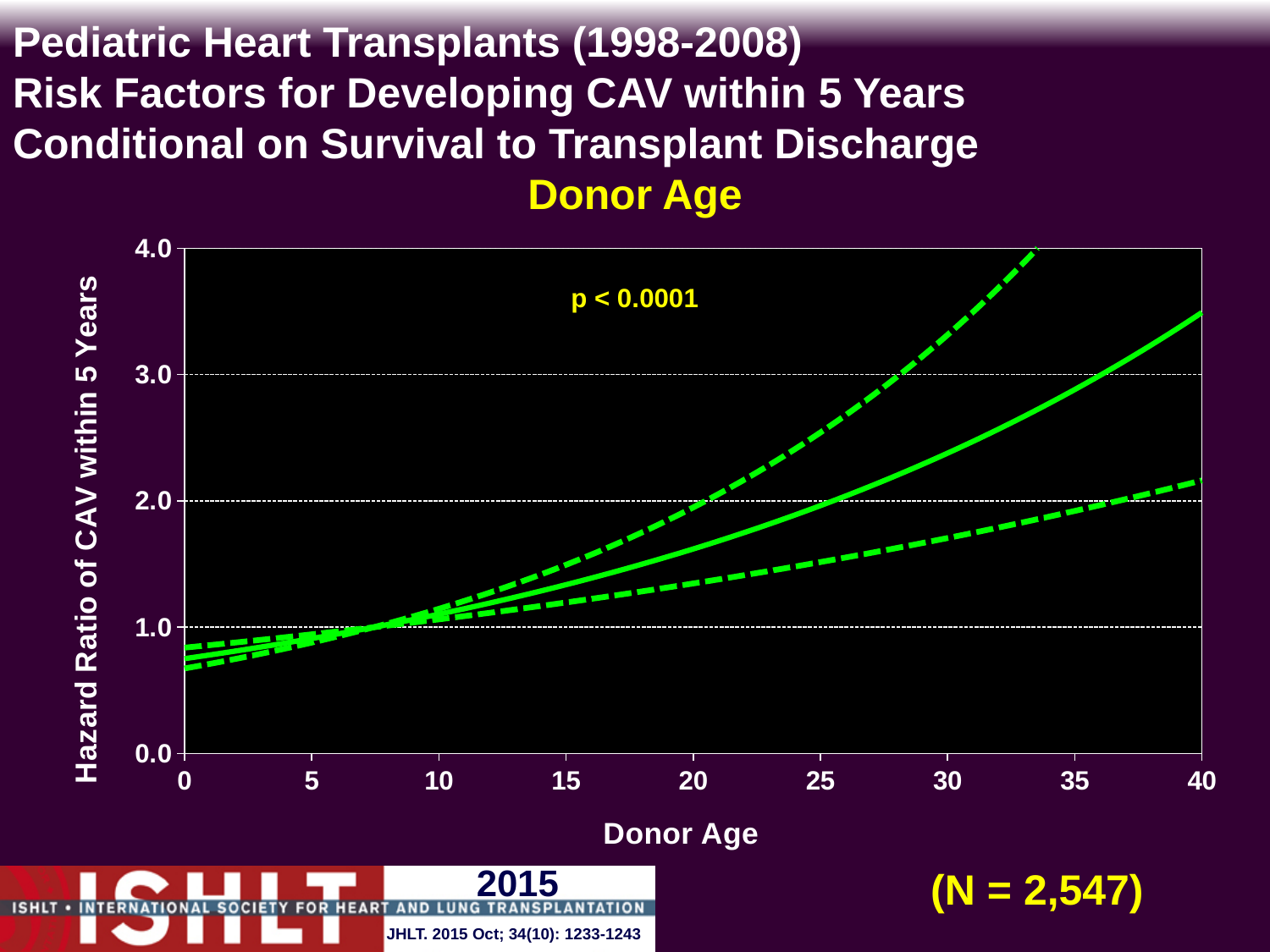
What is the maximum value shown on the y axis? 4.0 Is the value of the solid line at donor age 20 greater or less than 2.0? less How many lines are plotted on the chart? 3 What kind of chart is shown on the slide? line chart Is the value of the upper dashed line at donor age 30 greater or less than 3.0? greater Does the hazard ratio of CAV within 5 years rise or fall as donor age increases? rise Is the value of the lower dashed line at donor age 40 greater or less than 3.0? less What p-value is printed on the chart? p < 0.0001 At donor age 30, which is larger: the upper dashed line or the solid line? upper dashed line